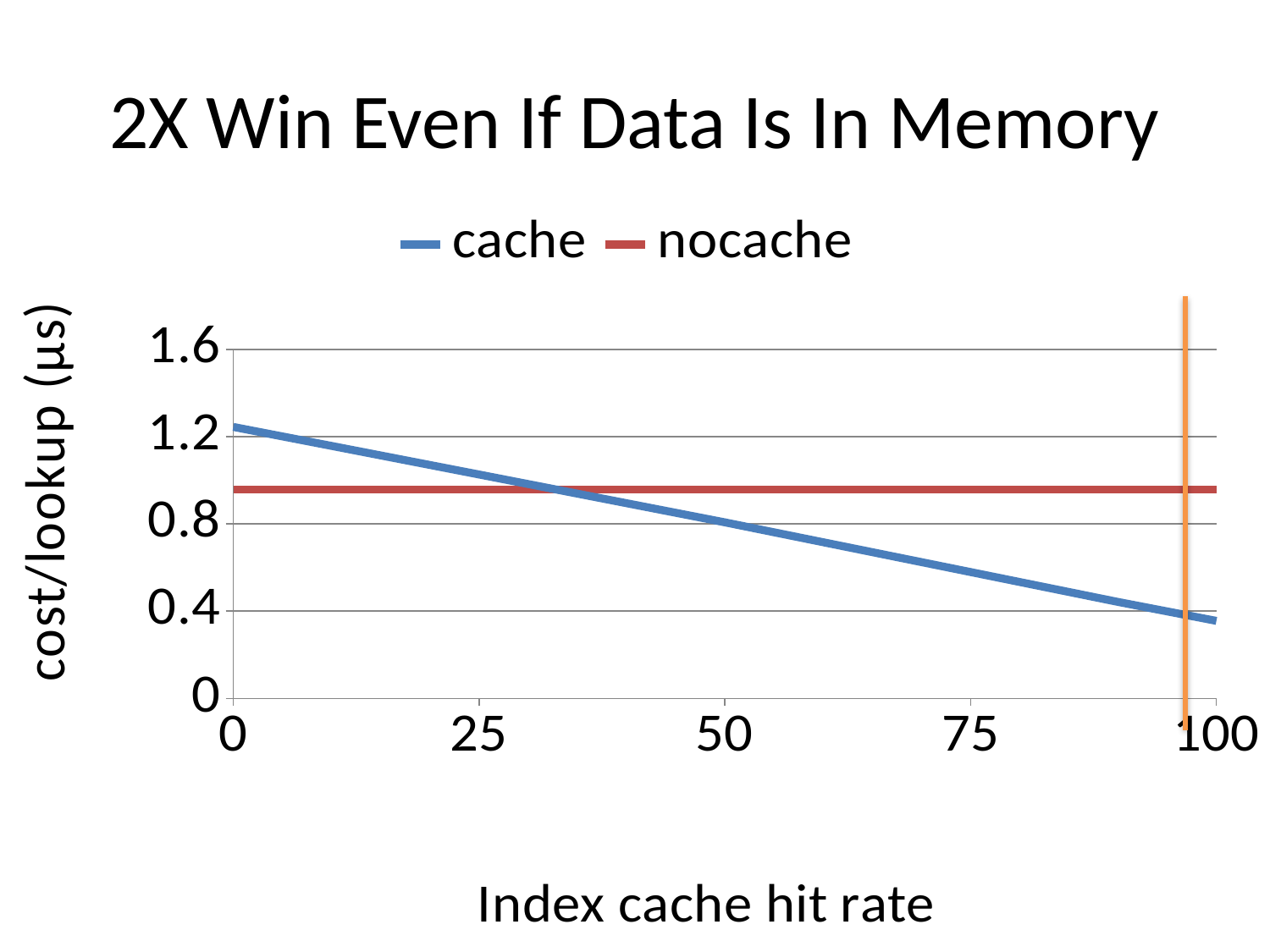
Is the cost/lookup for the nocache series greater or less than 0.8? greater Does the cache series rise or fall as the index cache hit rate increases? fall Is the cost/lookup for the cache series at a hit rate of 100 greater or less than 0.4? less What is the label of the x axis? Index cache hit rate Is the cost/lookup for the cache series at a hit rate of 25 greater or less than 0.8? greater At an index cache hit rate of 75, which series has the lower cost/lookup, cache or nocache? cache Does the nocache series rise, fall, or stay flat as the index cache hit rate increases? stay flat What kind of chart is shown on the slide? line chart How many series does the legend list? 2 At an index cache hit rate of 0, which series has the higher cost/lookup, cache or nocache? cache